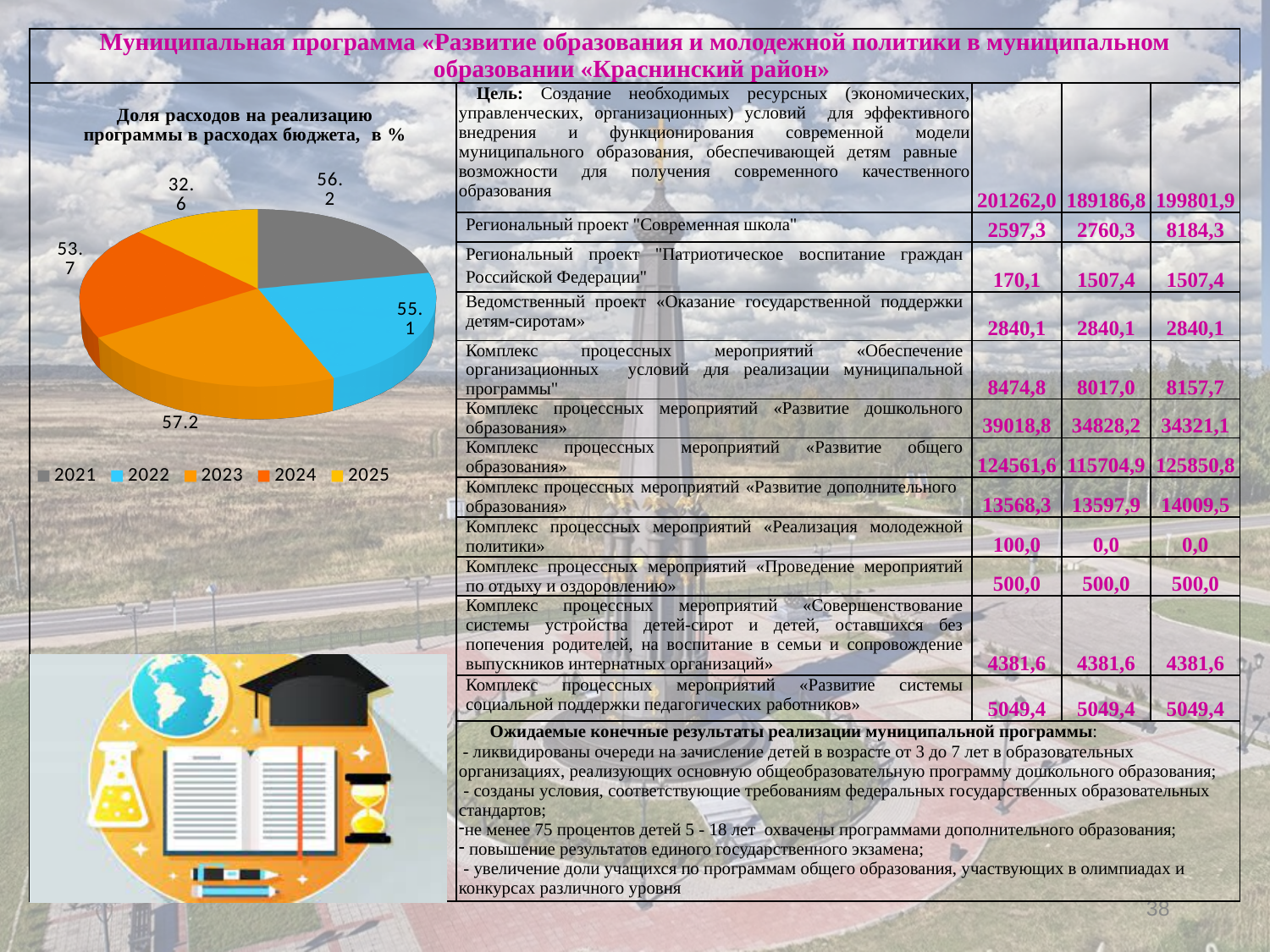
What is the value shown for 2021 in the pie chart? 56.2 Which year has the largest value in the pie chart? 2023 What is the value shown for 2022 in the pie chart? 55.1 What type of chart is shown on the slide? pie chart What is the value shown for 2025 in the pie chart? 32.6 What is the title of the pie chart? Доля расходов на реализацию программы в расходах бюджета, в % What is the difference between the values for 2021 and 2025 in the pie chart? 23.6 Which is larger in the pie chart, the value for 2022 or the value for 2024? 2022 Which year has the smallest slice in the pie chart? 2025 How many slices does the pie chart have? 5 How many entries does the legend of the pie chart list? 5 What is the value shown for 2023 in the pie chart? 57.2